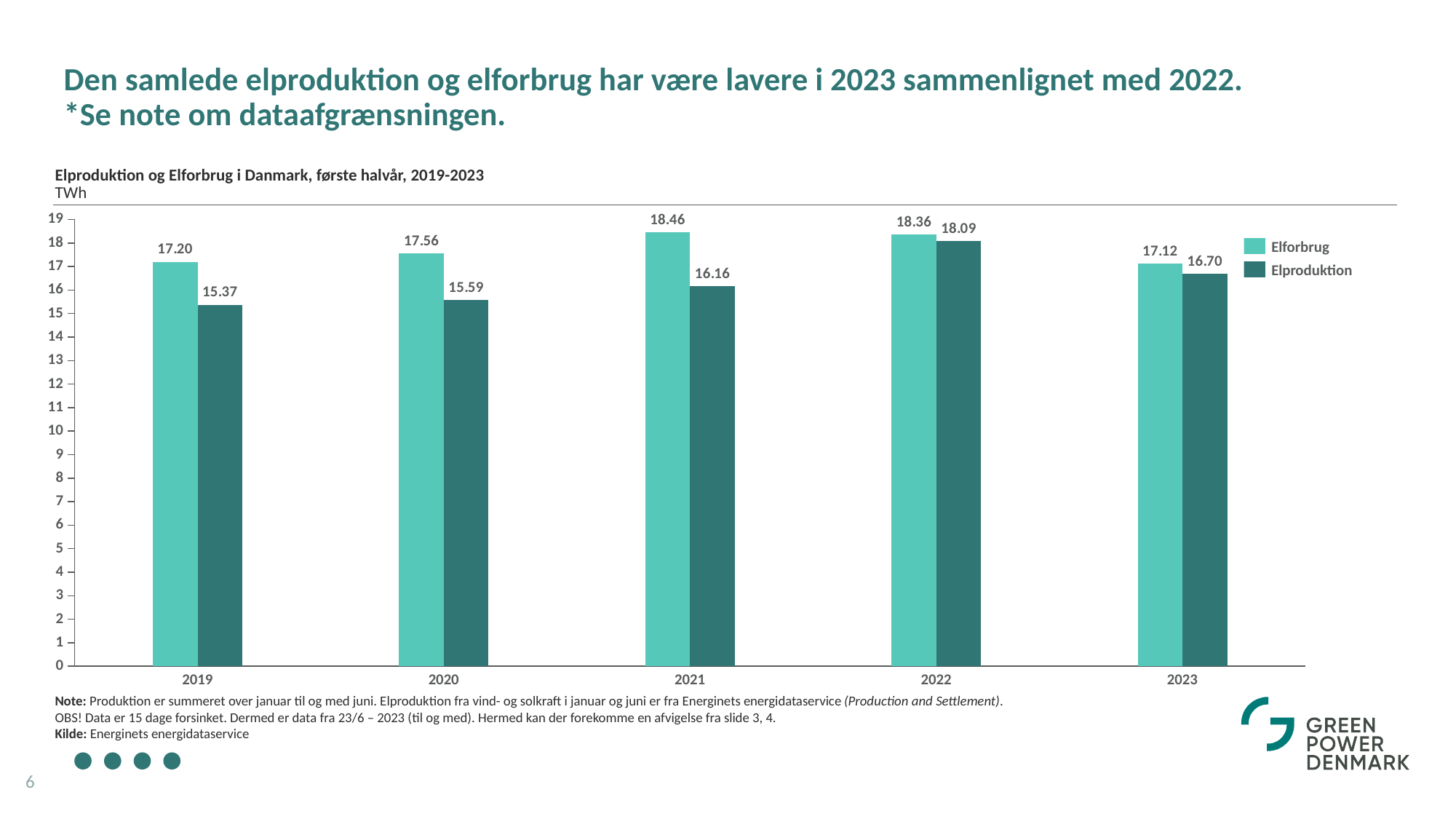
Which is larger in 2020, Elforbrug or Elproduktion? Elforbrug Which year has the lowest Elproduktion value? 2019 What is the Elproduktion value for 2019? 15.37 What is the Elproduktion value for 2023? 16.70 What is the Elforbrug value for 2021? 18.46 Which year has the highest Elforbrug value? 2021 How many years are shown on the x axis? 5 What is the difference between Elforbrug and Elproduktion in 2022? 0.27 What unit is shown for the chart's values? TWh Does Elproduktion rise or fall from 2022 to 2023? Fall How many series does the legend list? 2 What kind of chart is shown on the slide? Bar chart